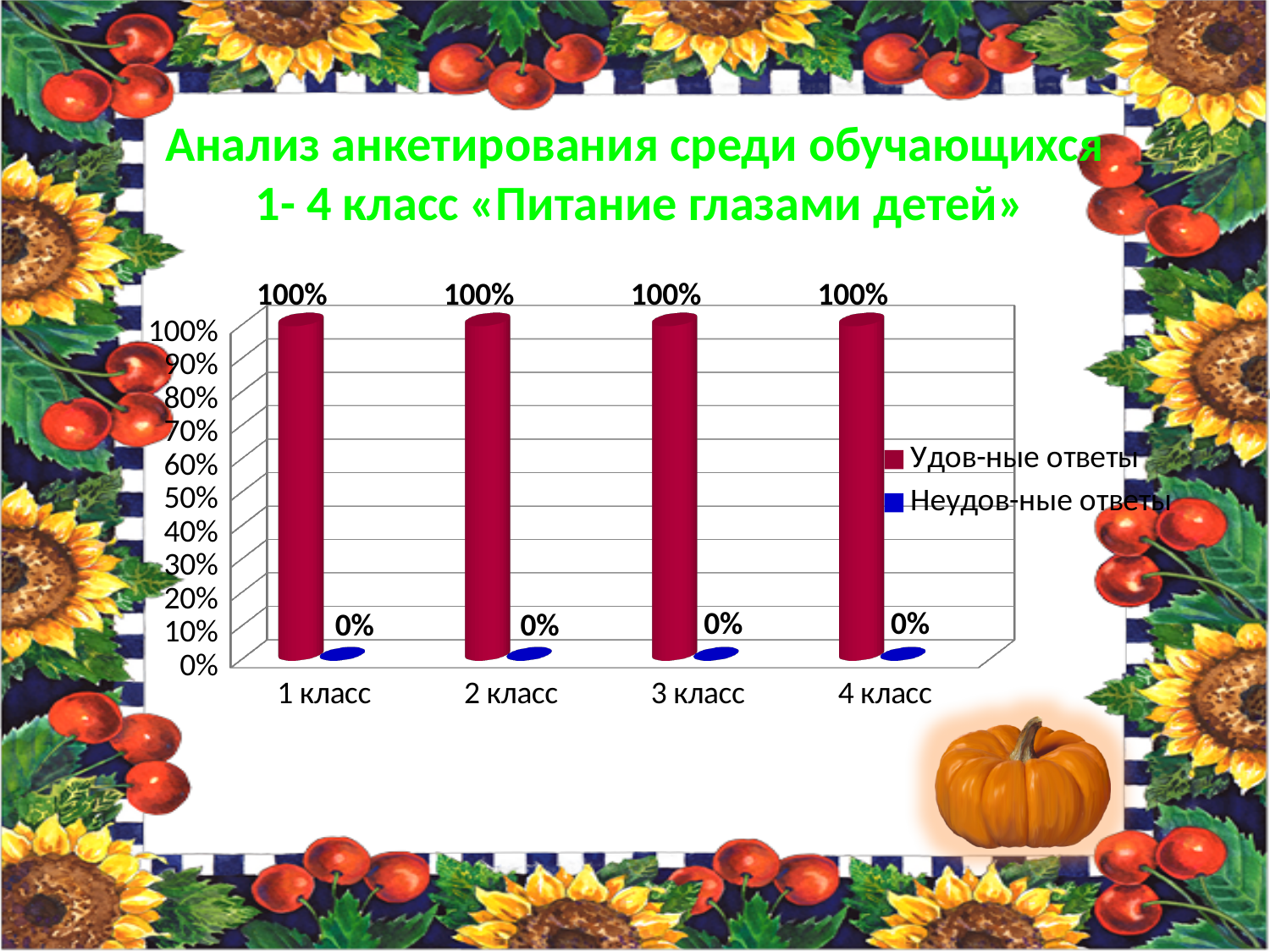
What is the value for Удов-ные ответы in 4 класс? 100% Which series is shown in dark red in the legend? Удов-ные ответы Which is larger in 2 класс: Удов-ные ответы or Неудов-ные ответы? Удов-ные ответы Do the values for Удов-ные ответы rise, fall, or stay the same from 1 класс to 4 класс? Stay the same What is the value for Неудов-ные ответы in 3 класс? 0% How many classes (categories) are shown on the x axis? 4 What is the value for Неудов-ные ответы in 2 класс? 0% What kind of chart is shown on the slide? Bar chart What is the difference between Удов-ные ответы and Неудов-ные ответы in 3 класс? 100% How many series does the legend list? 2 What is the value for Удов-ные ответы in 1 класс? 100% Is the value for Удов-ные ответы in 2 класс greater or less than 50%? greater